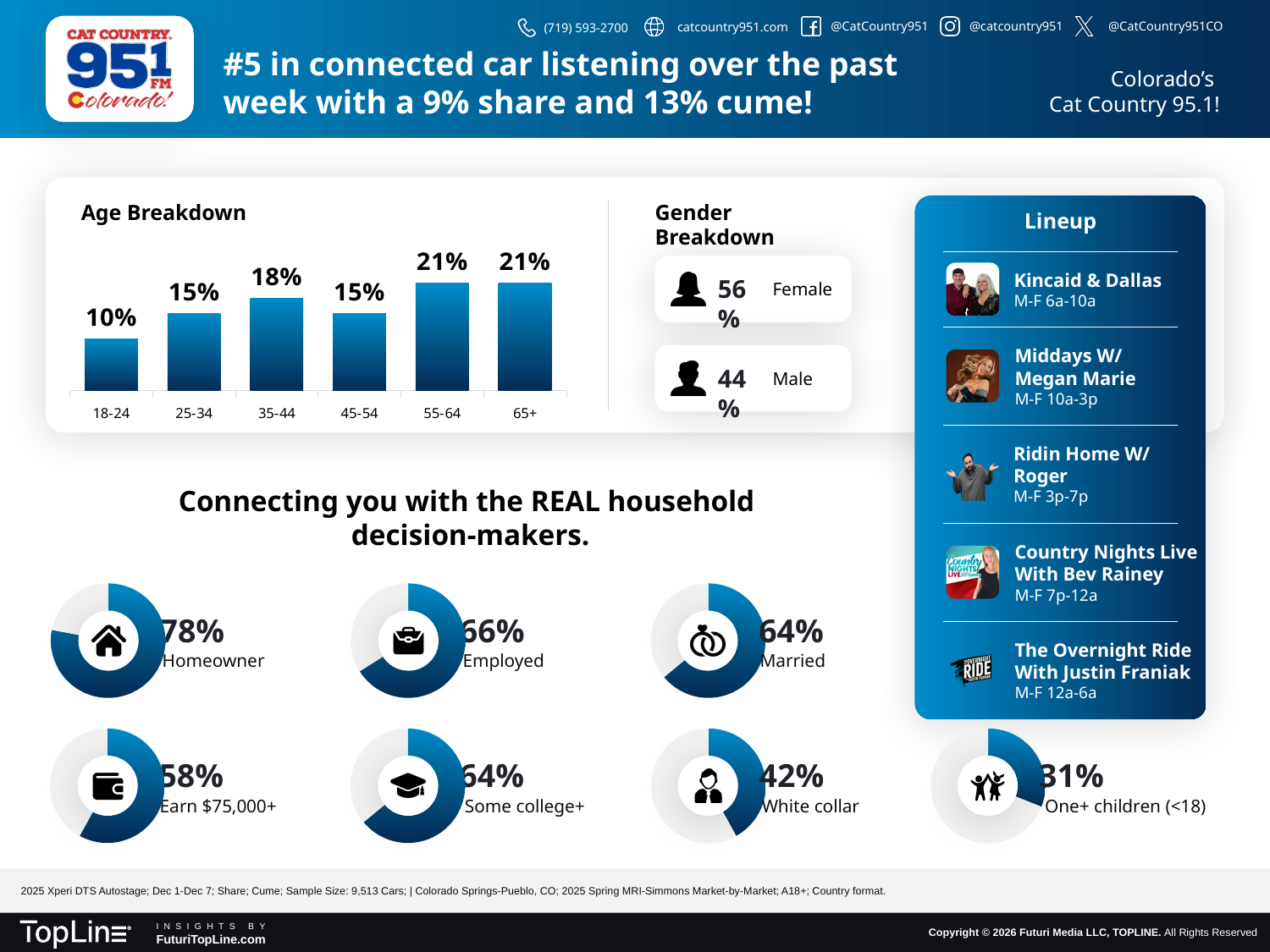
In the donut chart labeled Homeowner, what percentage is shown? 78% In the Age Breakdown chart, which age group has the lowest value? 18-24 What kind of chart is the Age Breakdown chart? Bar chart In the Age Breakdown chart, which is larger, the value for 25-34 or the value for 35-44? 35-44 In the Age Breakdown chart, what is the value for the 18-24 age group? 10% Among the donut charts at the bottom of the slide, which category has the lowest percentage? One+ children (<18) How many age groups are shown in the Age Breakdown chart? 6 In the Age Breakdown chart, what is the difference between the 55-64 value and the 18-24 value? 11% In the Gender Breakdown, what is the difference between the Female and Male percentages? 12% In the Age Breakdown chart, what is the value for the 35-44 age group? 18% In the Age Breakdown chart, which age groups share the highest value? 55-64 and 65+ In the Gender Breakdown, what percentage is Female? 56%